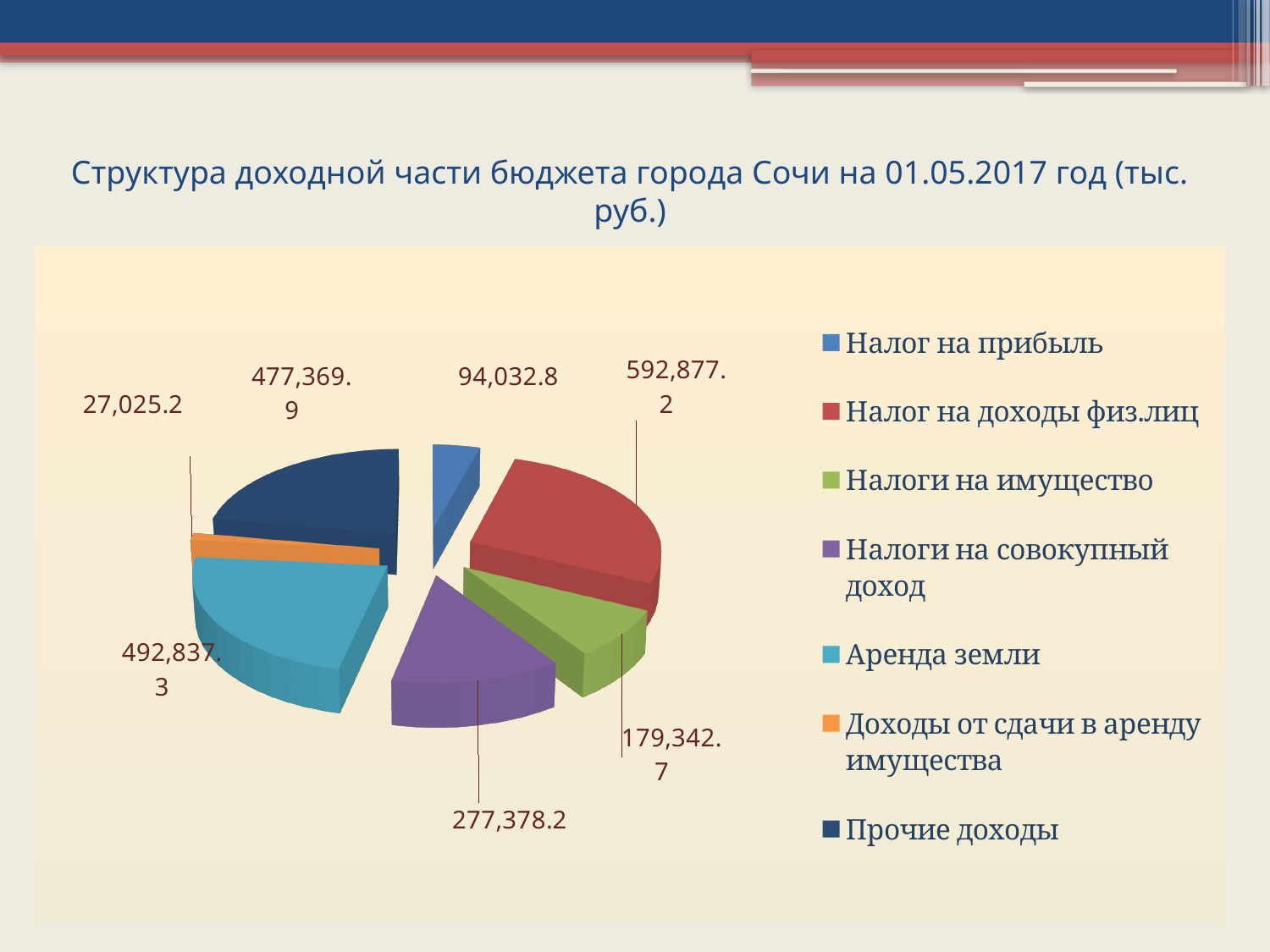
What is the value for Налоги на совокупный доход? 277,378.2 What is the title of the chart? Структура доходной части бюджета города Сочи на 01.05.2017 год (тыс. руб.) How many categories does the pie chart have? 7 Which is larger: Прочие доходы or Налоги на имущество? Прочие доходы What type of chart is shown on the slide? Pie chart What is the value for Налог на прибыль? 94,032.8 Which category has the largest slice of the pie? Налог на доходы физ.лиц What is the value for Доходы от сдачи в аренду имущества? 27,025.2 What is the value for Налог на доходы физ.лиц? 592,877.2 What is the difference between the values for Налог на доходы физ.лиц and Аренда земли? 100,039.9 What is the value for Аренда земли? 492,837.3 Which category has the smallest slice of the pie? Доходы от сдачи в аренду имущества